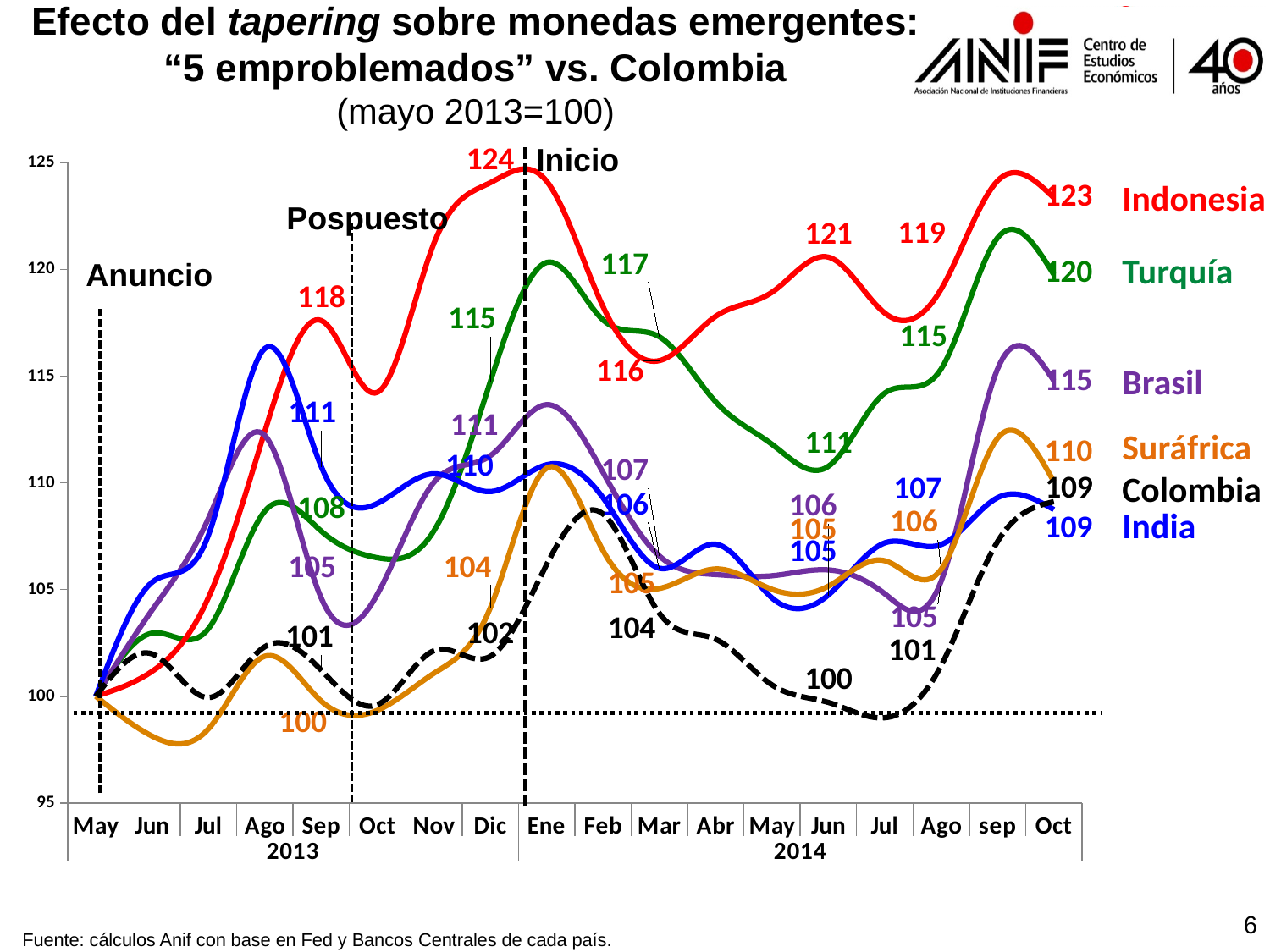
At Oct 2014, which is larger: Brasil or Suráfrica? Brasil What is the value for Indonesia at the end of the series (Oct 2014)? 123 How many currency series are plotted on the chart? 6 How many months are labelled along the x axis? 18 Which currency has the highest value at Oct 2014? Indonesia Which series has the lowest labelled value at Ago 2014? Colombia What is the highest value labelled for Indonesia on the chart? 124 Is the value for Suráfrica at Jun 2013 greater or less than 100? less What is the difference between the Oct 2014 values of Indonesia (123) and Turquía (120)? 3 What is the value for Turquía at Oct 2014? 120 What base value does the subtitle say the index is set to in May 2013? 100 What kind of chart is shown on the slide? Line chart